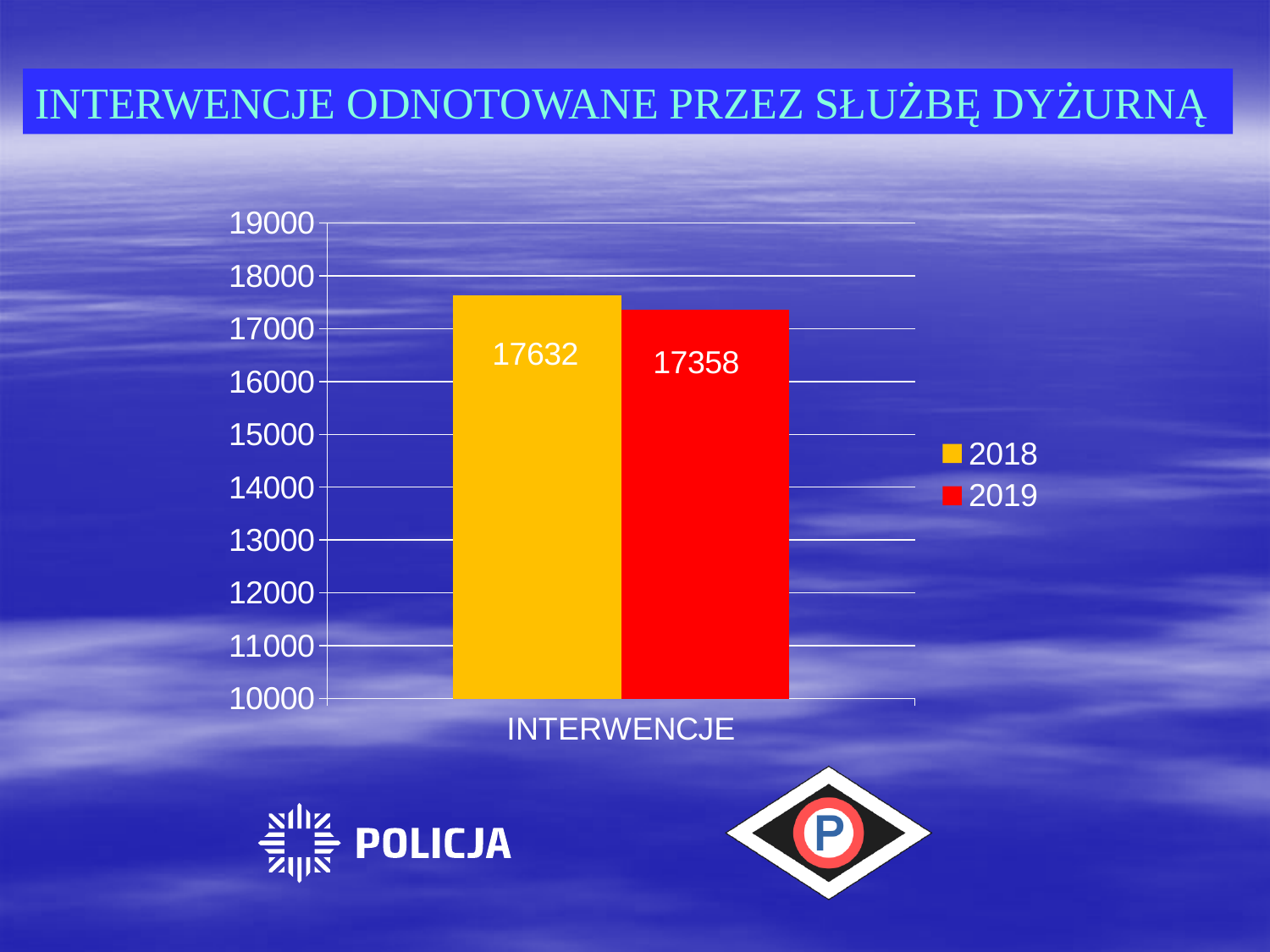
What colour represents the 2019 series in the chart? red Is the value for 2018 greater or less than 18000? less Which year has the higher value, 2018 or 2019? 2018 What is the value for 2018 in the INTERWENCJE chart? 17632 Which series has the lowest value in the chart? 2019 What is the difference between the 2018 and 2019 values? 274 Is the value for 2019 greater or less than 17000? greater What kind of chart is shown on the slide? bar chart What is the value for 2019 in the INTERWENCJE chart? 17358 What is the category label on the x axis of the chart? INTERWENCJE Did the number of interventions rise or fall from 2018 to 2019? fall How many series does the legend list? 2